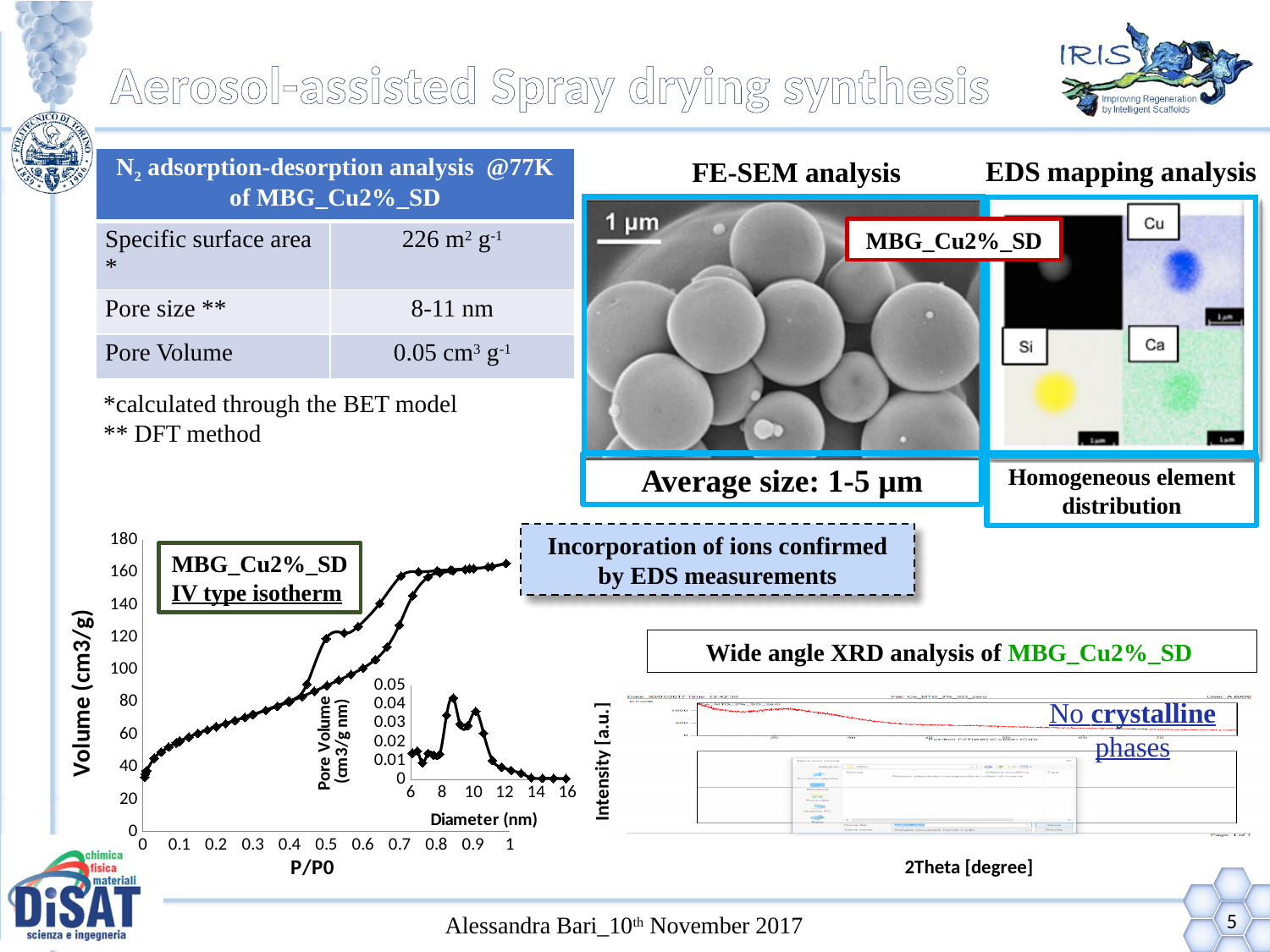
In the isotherm chart at the bottom left, what is the label of the x axis? P/P0 In the inset pore size distribution chart, what is the label of the x axis? Diameter (nm) In the inset pore size distribution chart (Pore Volume vs Diameter), is the peak pore volume greater or less than 0.03? greater What kind of chart is the N2 adsorption-desorption isotherm plot at the bottom left of the slide (Volume vs P/P0)? line chart In the isotherm chart at the bottom left, what is the maximum value shown on the y axis? 180 In the isotherm chart at the bottom left, is the volume at P/P0 = 1 greater or less than 140? greater In the isotherm chart at the bottom left, does the adsorbed volume rise or fall as P/P0 increases from 0 to 1? rise In the isotherm chart at the bottom left, is the volume at P/P0 = 0 greater or less than 40? less